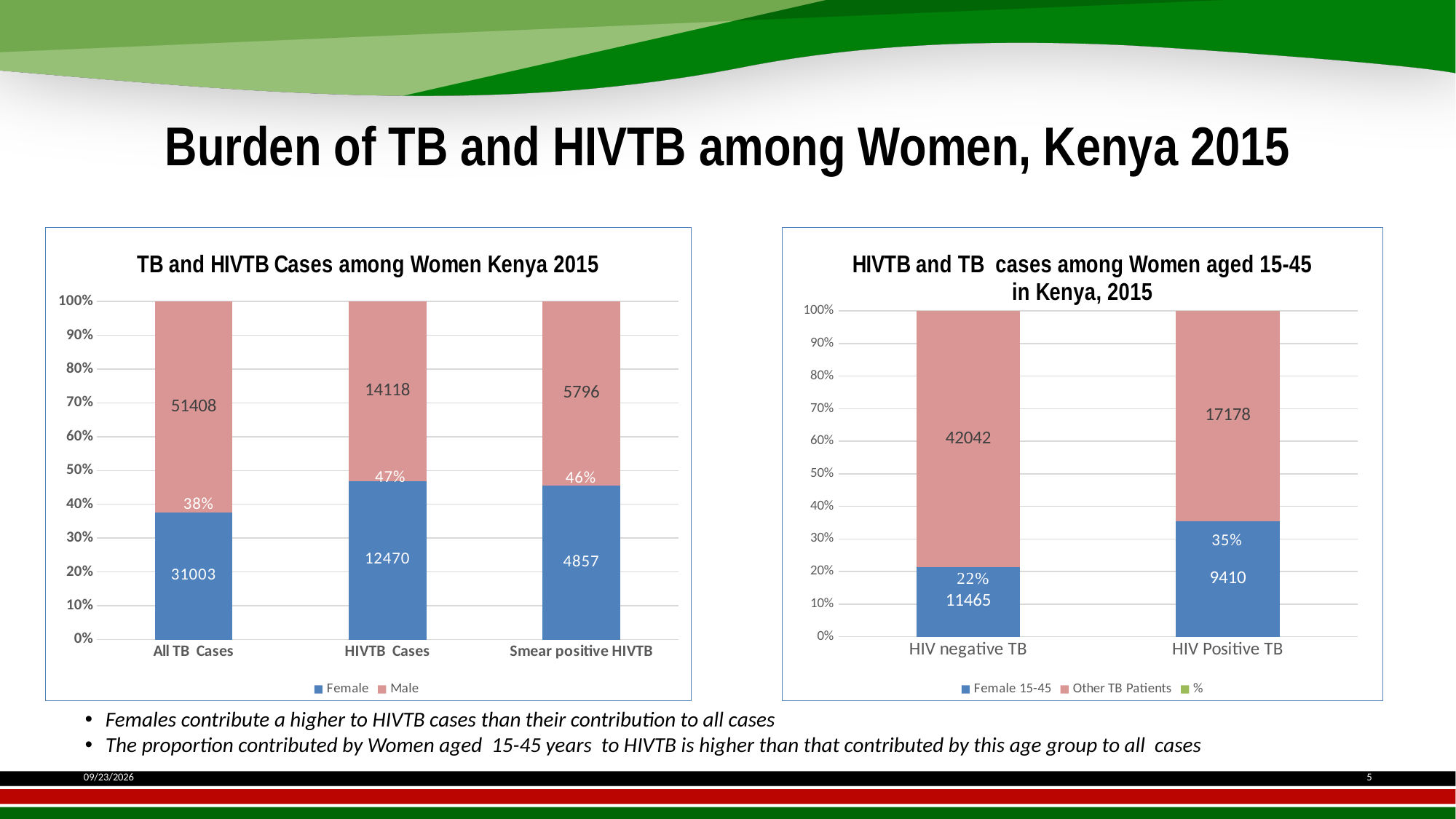
In the chart titled "HIVTB and TB cases among Women aged 15-45 in Kenya, 2015", what is the Female 15-45 value for HIV Positive TB? 9410 In the chart titled "HIVTB and TB cases among Women aged 15-45 in Kenya, 2015", which category has the larger Female 15-45 value, HIV negative TB or HIV Positive TB? HIV negative TB In the chart titled "HIVTB and TB cases among Women aged 15-45 in Kenya, 2015", what is the total of the Female 15-45 and Other TB Patients values for HIV Positive TB? 26588 In the chart titled "HIVTB and TB cases among Women aged 15-45 in Kenya, 2015", what is the Other TB Patients value for HIV negative TB? 42042 In the chart titled "TB and HIVTB Cases among Women Kenya 2015", how many categories are shown on the x axis? 3 What kind of chart is the chart on the right of the slide? Stacked bar chart In the chart titled "TB and HIVTB Cases among Women Kenya 2015", what percentage label is shown on the Female segment for Smear positive HIVTB? 46% In the chart titled "TB and HIVTB Cases among Women Kenya 2015", what is the difference between the Male and Female values for All TB Cases? 20405 In the chart titled "TB and HIVTB Cases among Women Kenya 2015", what is the Male value for HIVTB Cases? 14118 In the chart titled "TB and HIVTB Cases among Women Kenya 2015", what is the total of the Female and Male values for Smear positive HIVTB? 10653 In the chart titled "TB and HIVTB Cases among Women Kenya 2015", how many series does the legend list? 2 In the chart titled "TB and HIVTB Cases among Women Kenya 2015", what is the Female value for All TB Cases? 31003